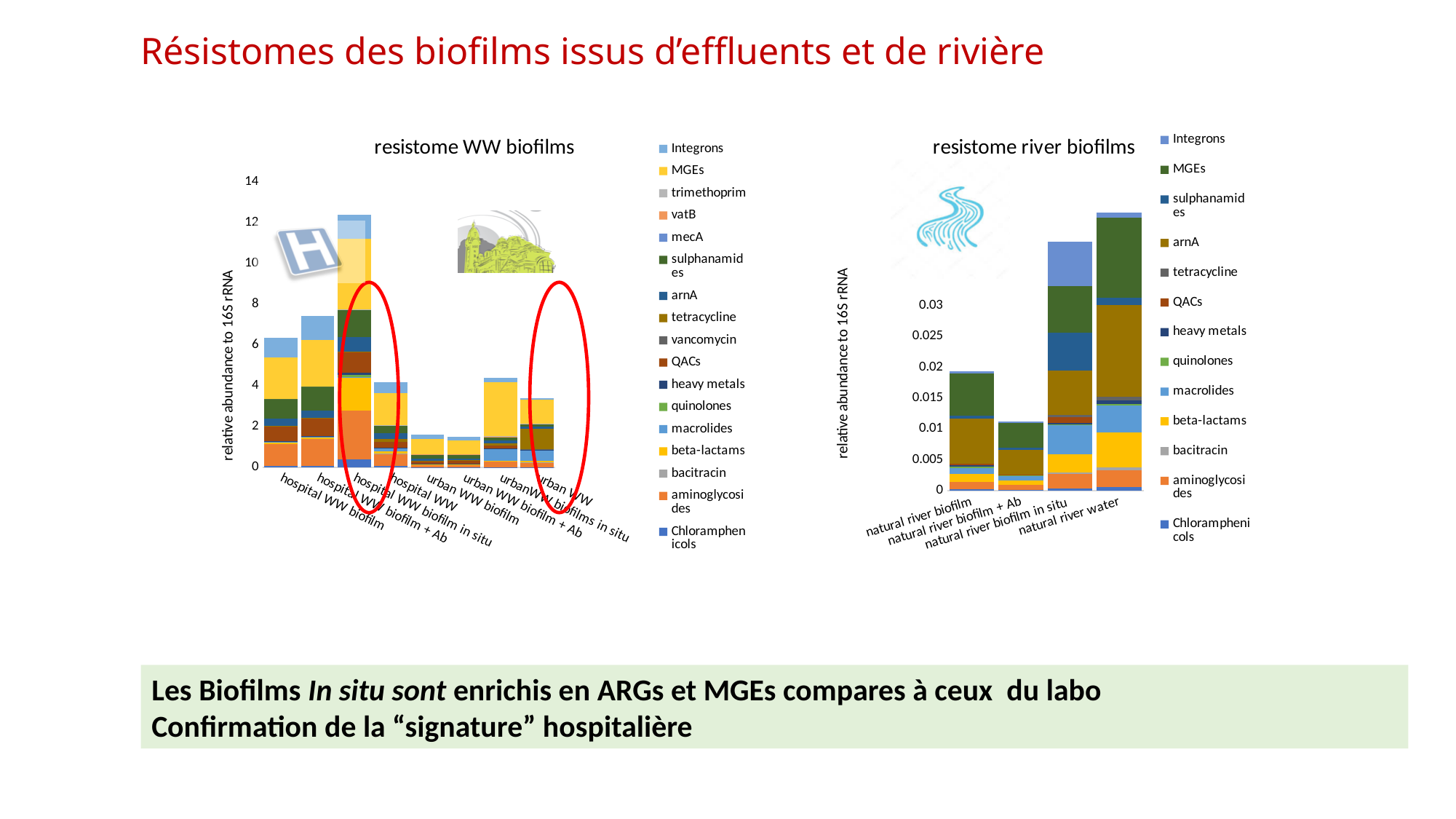
In the "resistome WW biofilms" chart, how many bars (categories) are plotted? 8 In the "resistome river biofilms" chart, which category has the shortest stacked bar? natural river biofilm + Ab What type of chart is the "resistome WW biofilms" chart? stacked bar chart In the "resistome river biofilms" chart, how many bars (categories) are plotted? 4 In the "resistome river biofilms" chart, which bar is taller: natural river biofilm or natural river biofilm + Ab? natural river biofilm How many series does the legend of the "resistome WW biofilms" chart list? 17 In the "resistome WW biofilms" chart, is the total for hospital WW biofilm in situ greater or less than 10? greater In the "resistome river biofilms" chart, is the total for natural river water greater or less than 0.03? greater How many series does the legend of the "resistome river biofilms" chart list? 13 In the "resistome river biofilms" chart, which category has the tallest stacked bar? natural river water What is the y-axis label of the "resistome WW biofilms" chart? relative abundance to 16S rRNA In the "resistome WW biofilms" chart, which category has the tallest stacked bar? hospital WW biofilm in situ